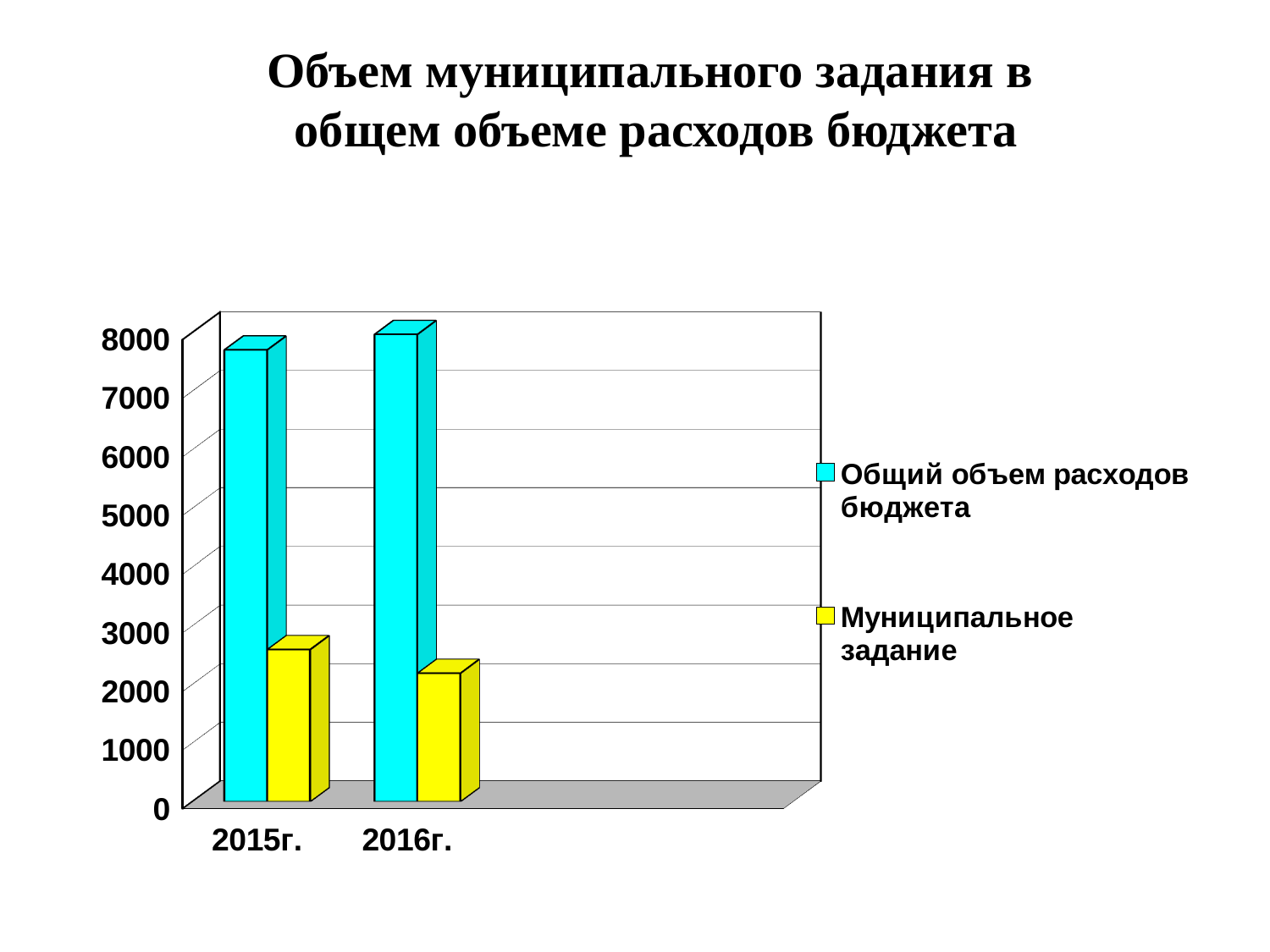
What is the title of the chart on the slide? Объем муниципального задания в общем объеме расходов бюджета Which colour represents the series "Муниципальное задание" in the legend? yellow Which year has the larger value for "Муниципальное задание", 2015г. or 2016г.? 2015г. Is the value of "Муниципальное задание" for 2015г. greater or less than 3000? less Is the value of "Муниципальное задание" for 2016г. greater or less than 3000? less Is the value of "Общий объем расходов бюджета" for 2016г. greater or less than 6000? greater Does the value of "Общий объем расходов бюджета" rise or fall from 2015г. to 2016г.? rise How many series does the legend list? 2 How many categories (years) are shown on the x axis? 2 Does the value of "Муниципальное задание" rise or fall from 2015г. to 2016г.? fall What kind of chart is shown on the slide? bar chart